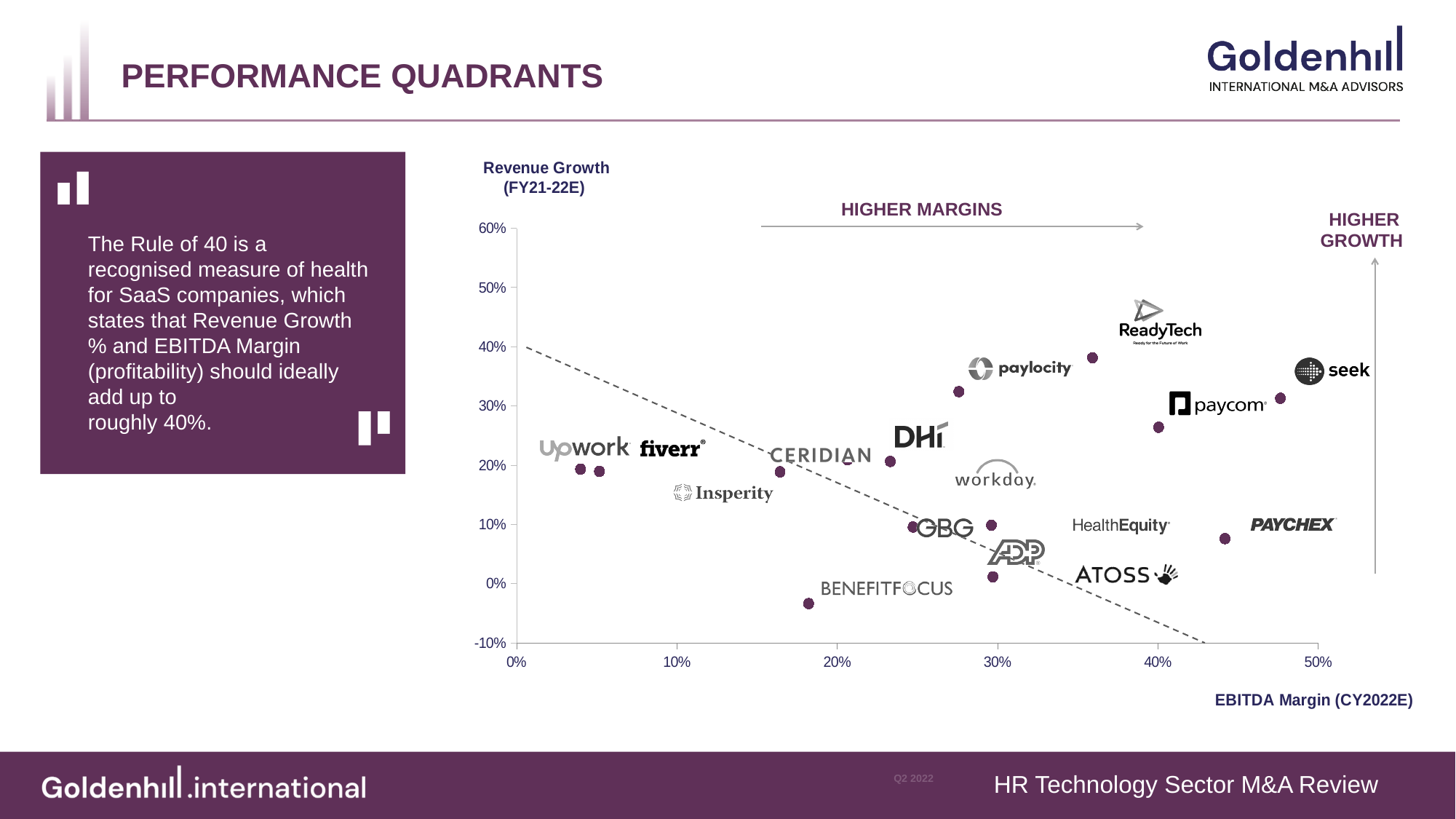
Is the revenue growth for Paycom greater or less than 20%? greater What kind of chart is shown on the slide? Scatter chart What is the label of the vertical axis of the chart? Revenue Growth (FY21-22E) Is the revenue growth for Benefitfocus greater or less than 0%? less Which has the higher EBITDA margin, Seek or Upwork? Seek Which has the higher revenue growth, Seek or Benefitfocus? Seek Is the EBITDA margin for Seek greater or less than 40%? greater Which company has the lowest revenue growth on the chart? Benefitfocus What is the label of the horizontal axis of the chart? EBITDA Margin (CY2022E) Which company has the highest EBITDA margin on the chart? Seek